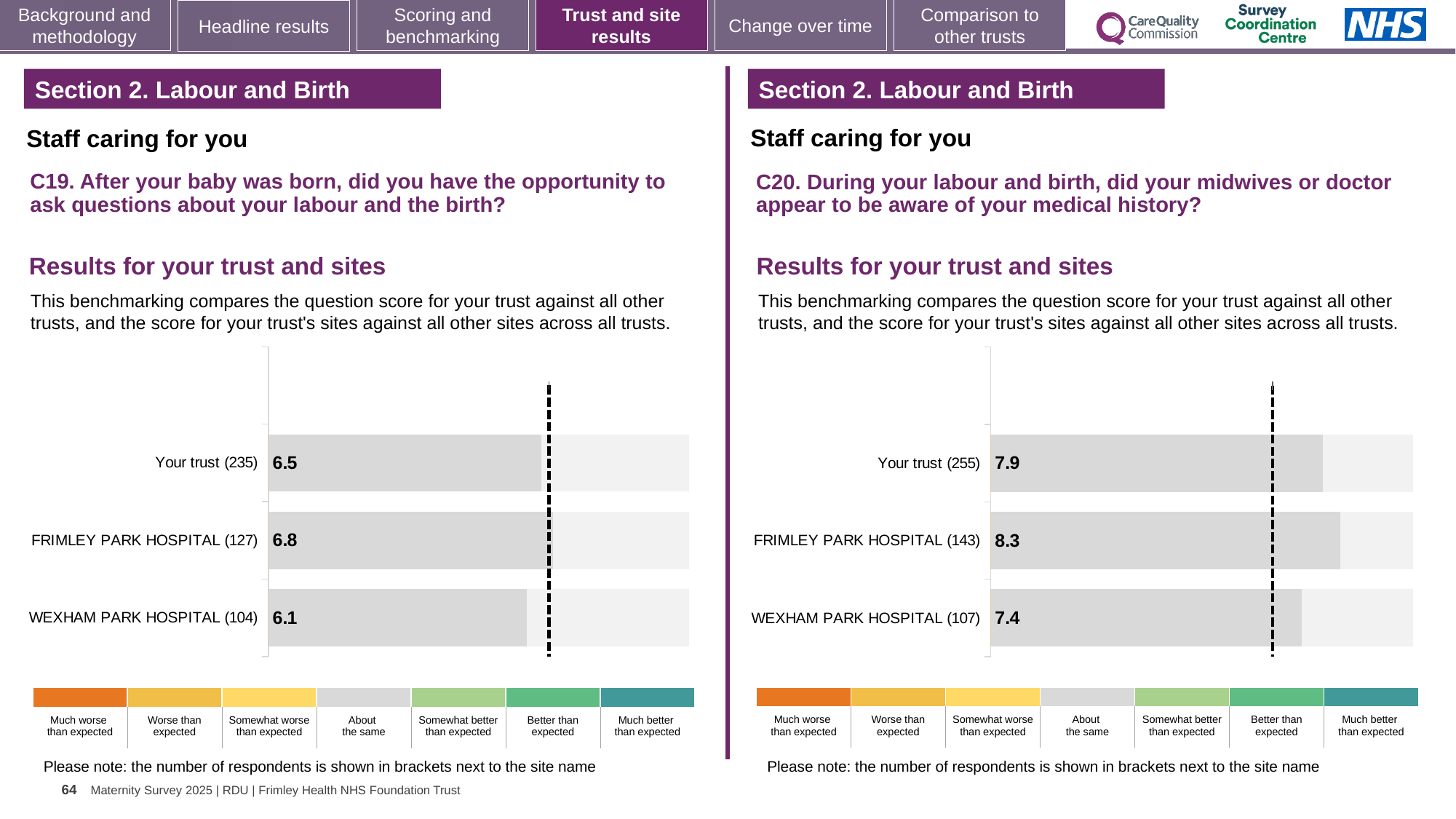
In the C20 chart on the right, what is the score for FRIMLEY PARK HOSPITAL? 8.3 In the C19 chart on the left, what is the score for Your trust? 6.5 In the C20 chart on the right, which category has the lowest score? WEXHAM PARK HOSPITAL How many categories (bars) are shown in the C19 chart on the left? 3 In the C19 chart on the left, how many respondents are shown in brackets for WEXHAM PARK HOSPITAL? 104 In the C20 chart on the right, which has the larger score, Your trust or WEXHAM PARK HOSPITAL? Your trust In the C20 chart on the right, what is the difference between the scores for FRIMLEY PARK HOSPITAL and Your trust? 0.4 In the C19 chart on the left, which category has the highest score? FRIMLEY PARK HOSPITAL In the C20 chart on the right, what is the score for Your trust? 7.9 In the C19 chart on the left, what is the score for WEXHAM PARK HOSPITAL? 6.1 In the C19 chart on the left, what is the difference between the scores for FRIMLEY PARK HOSPITAL and WEXHAM PARK HOSPITAL? 0.7 What kind of chart is used in the C20 chart on the right? Bar chart